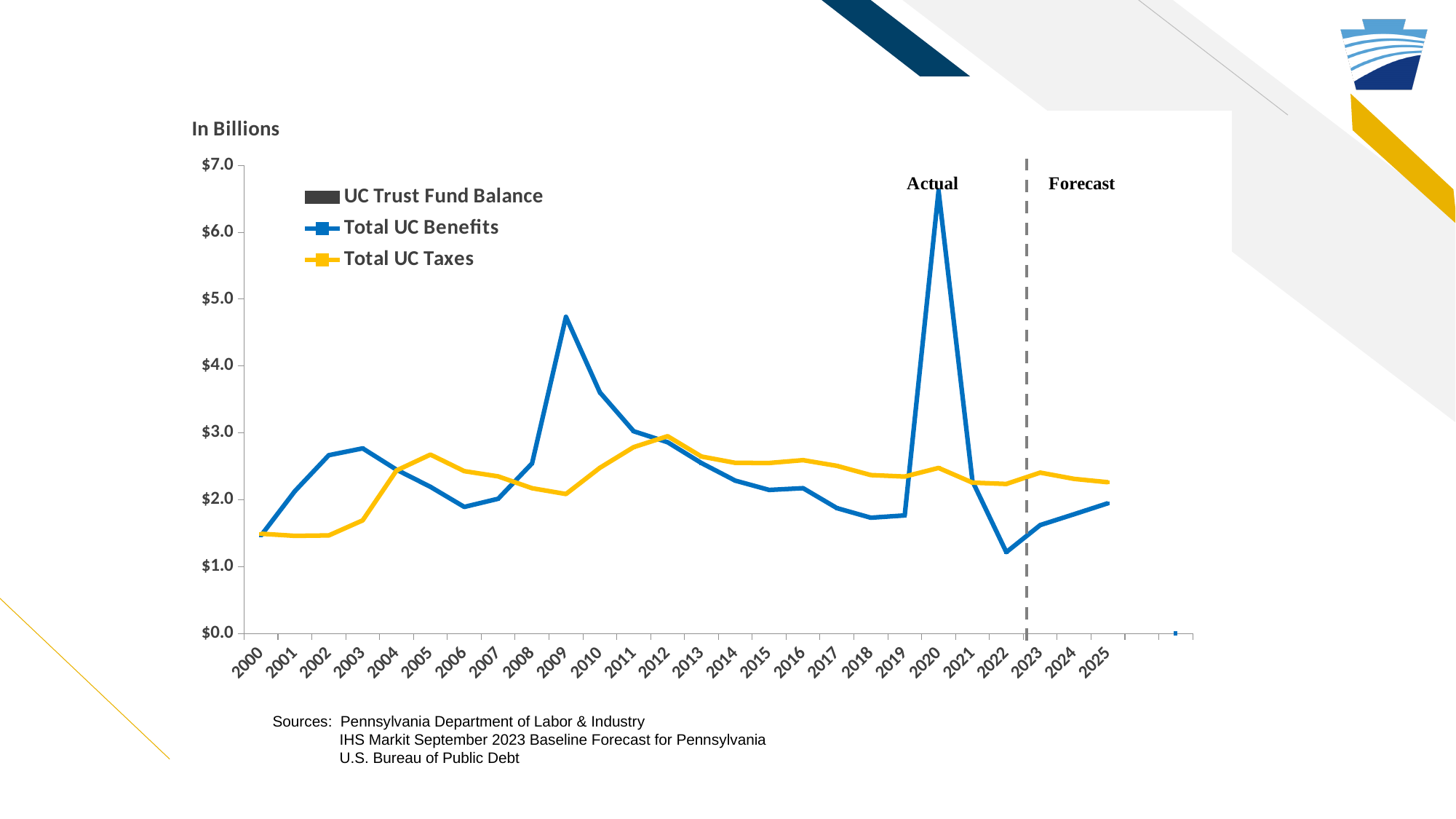
Is the value for Total UC Benefits in 2009 greater or less than $4.0? greater What kind of chart is shown on the slide? Line chart How many series does the legend list? 3 In which year does Total UC Benefits reach its highest value? 2020 What label separates the actual data from the forecast data on the chart? A dashed vertical line between Actual and Forecast In which year does Total UC Taxes reach its highest value? 2012 In which year is Total UC Benefits at its lowest? 2022 In 2018, which is larger: Total UC Benefits or Total UC Taxes? Total UC Taxes Is the value for Total UC Taxes in 2000 greater or less than $2.0? less How many years are labelled on the x axis? 26 Is the value for Total UC Benefits in 2020 greater or less than $6.0? greater Does Total UC Benefits rise or fall from 2020 to 2022? Fall